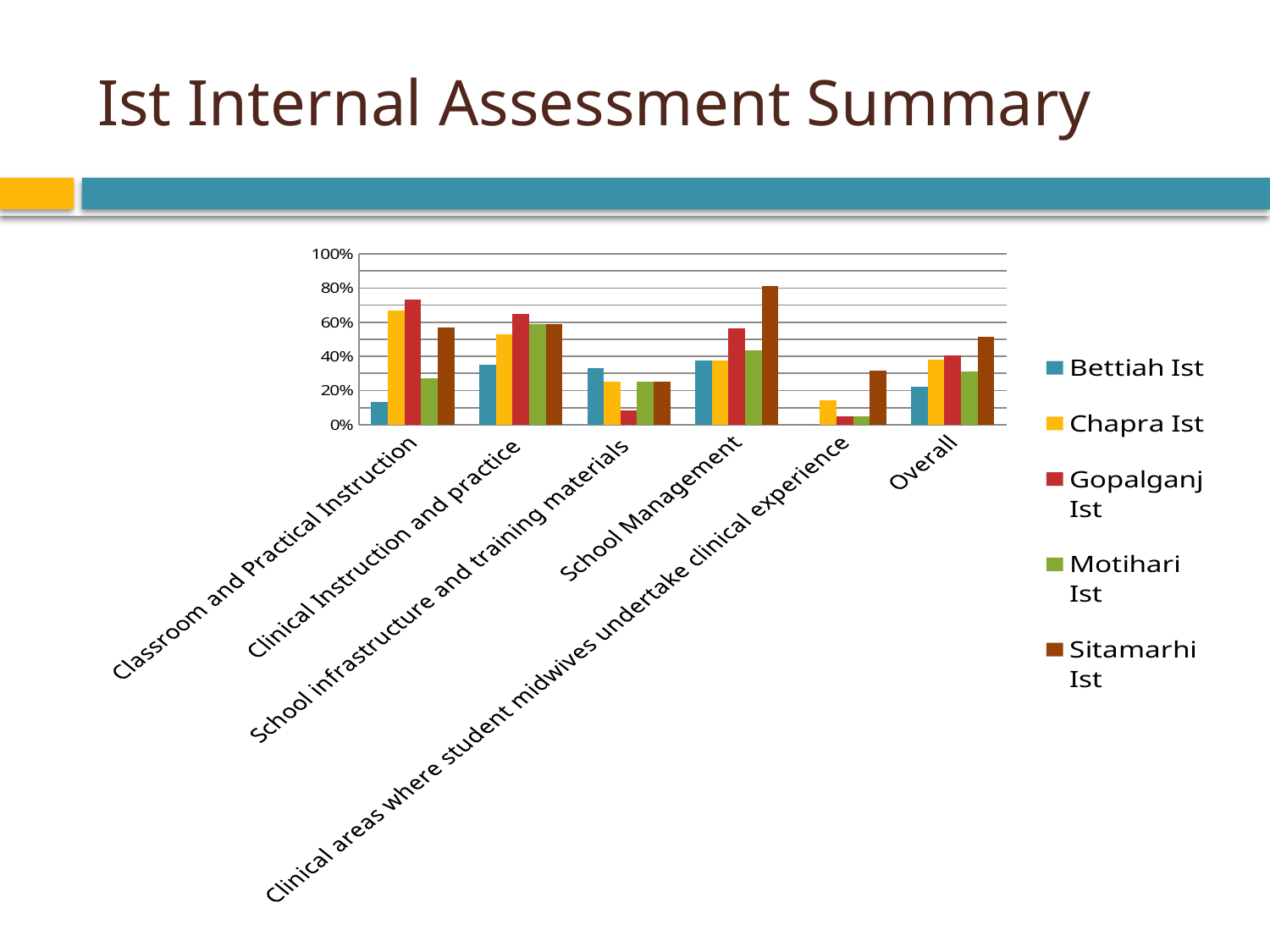
Is the value for Bettiah Ist in Classroom and Practical Instruction greater or less than 20%? less Which series has the highest value for Overall? Sitamarhi Ist Is the value for Sitamarhi Ist in School Management greater or less than 60%? greater Which series has the highest value for School Management? Sitamarhi Ist What kind of chart is shown on the slide? Bar chart Is the value for Gopalganj Ist in School infrastructure and training materials greater or less than 20%? less Which series has the highest value for Classroom and Practical Instruction? Gopalganj Ist How many categories are shown along the x axis? 6 For Overall, which is larger: Sitamarhi Ist or Bettiah Ist? Sitamarhi Ist Which series has the lowest value for Classroom and Practical Instruction? Bettiah Ist Which series has the lowest value for School infrastructure and training materials? Gopalganj Ist How many series does the legend list? 5